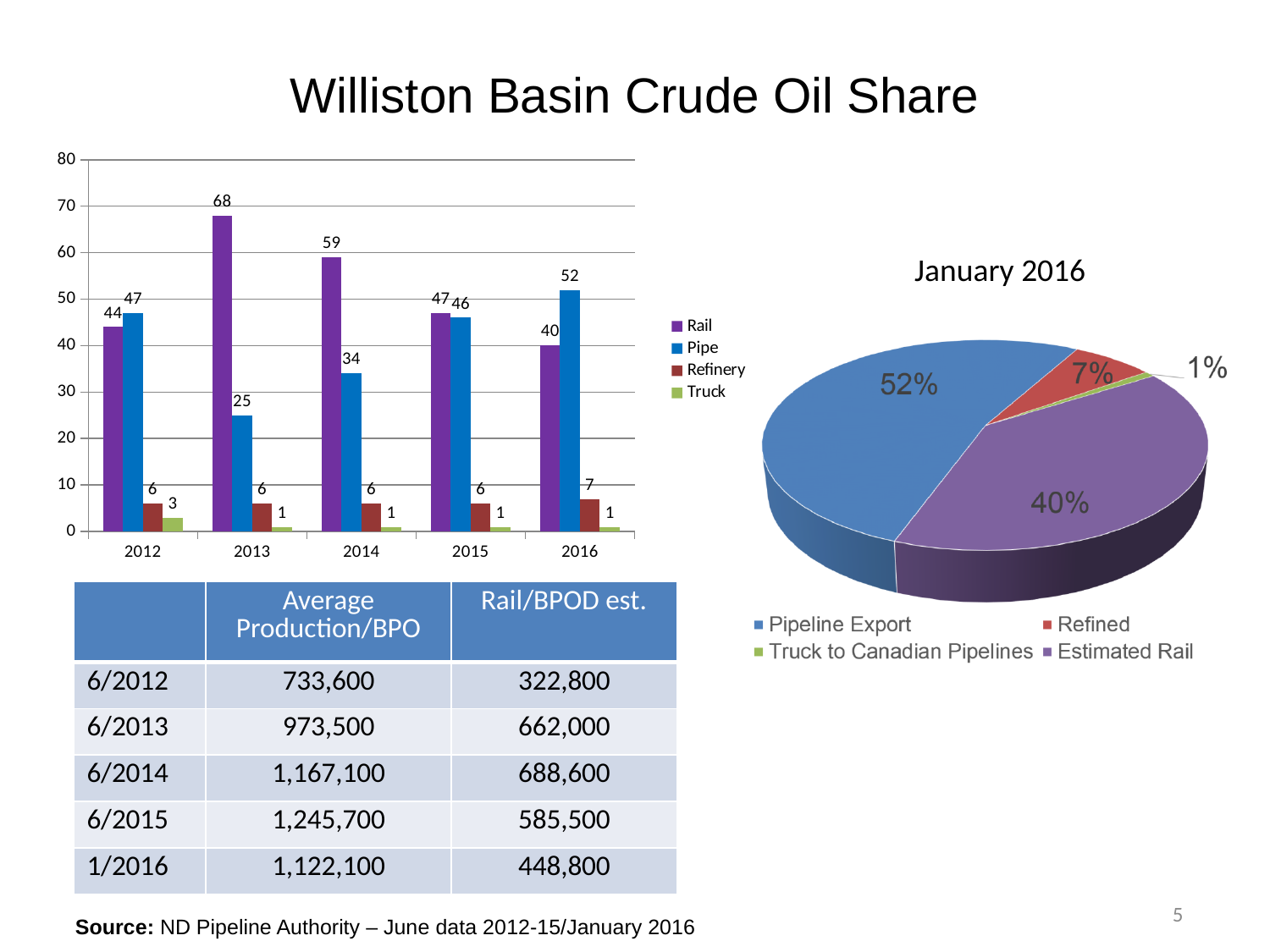
In the bar chart on the left, which year has the highest Rail value? 2013 How many years are shown on the x axis of the bar chart on the left? 5 In the bar chart on the left, what is the Pipe value for 2016? 52 What kind of chart is the chart on the right of the slide? pie chart In the pie chart titled January 2016, which category has the smallest share? Truck to Canadian Pipelines In the bar chart on the left, what is the Rail value for 2013? 68 In the bar chart on the left, is the Rail value or the Pipe value larger in 2016? Pipe How many series does the legend of the bar chart on the left list? 4 In the pie chart titled January 2016, what share is Pipeline Export? 52% In the bar chart on the left, which year has the lowest Pipe value? 2013 In the bar chart on the left, what is the difference between the Rail and Pipe values in 2014? 25 In the bar chart on the left, does the Rail value rise or fall from 2013 to 2016? fall